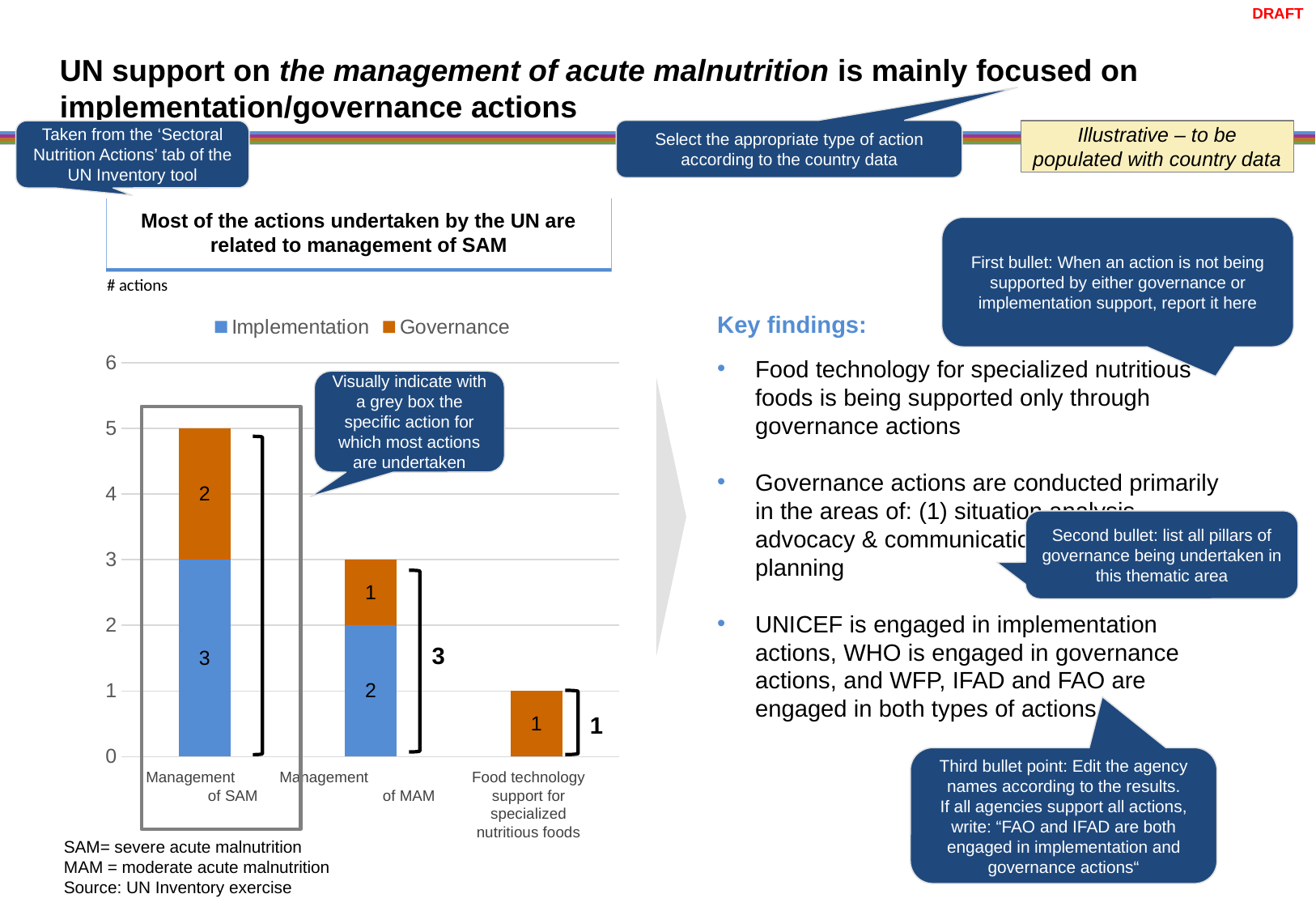
What type of chart is shown on the slide? stacked bar chart What is the Governance value for Management of SAM? 2 How many series does the chart legend list? 2 How many categories are shown on the x axis of the chart? 3 Which category has the lowest total number of actions? Food technology support for specialized nutritious foods What is the total number of actions for Management of SAM? 5 What is the Implementation value for Management of MAM? 2 What is the Implementation value for Management of SAM? 3 What is the total number of actions for Management of MAM? 3 What is the Governance value for Food technology support for specialized nutritious foods? 1 What is the difference between the Implementation values for Management of SAM and Management of MAM? 1 Which category has the highest total number of actions? Management of SAM